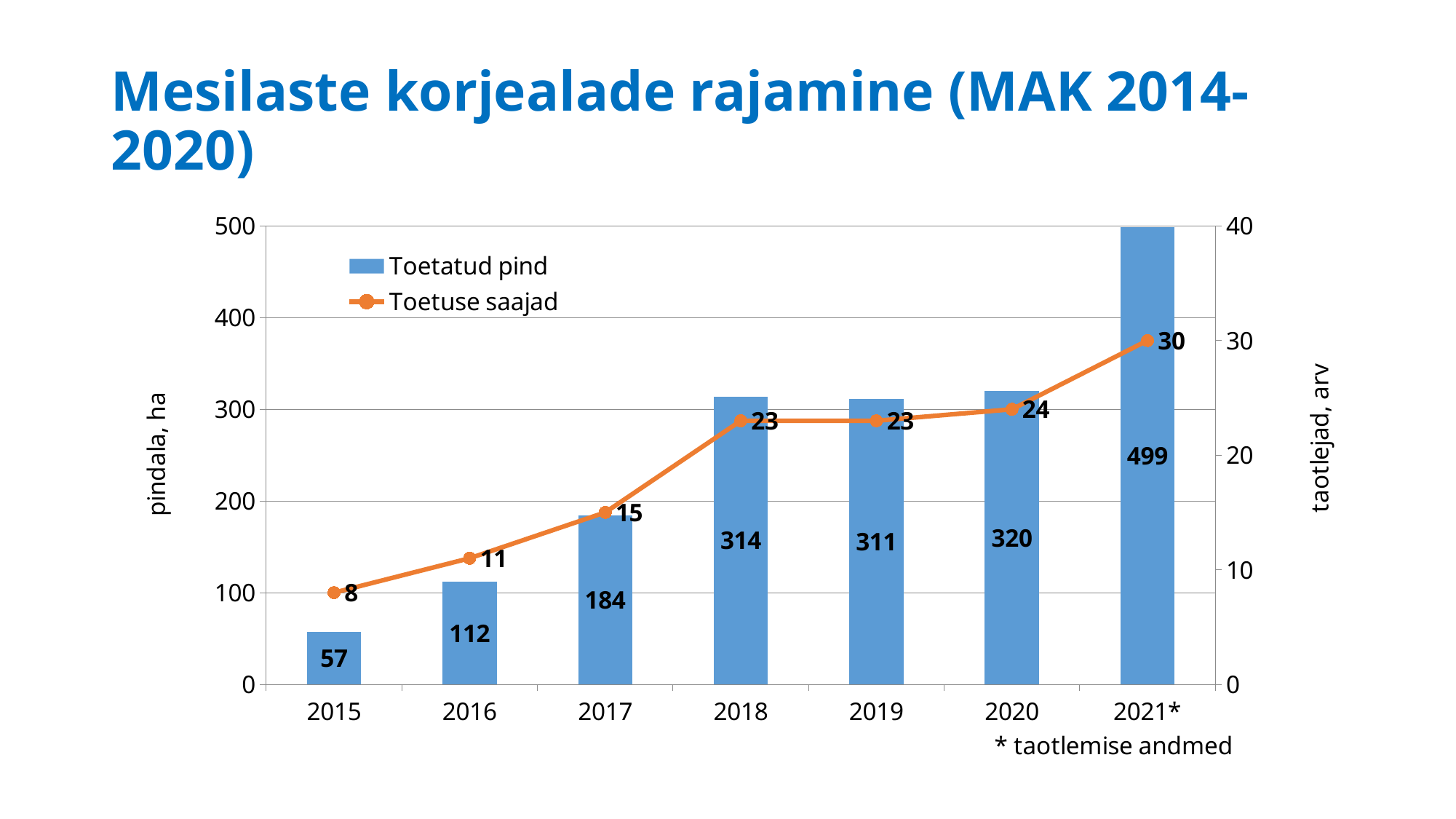
What is the difference between the Toetuse saajad values for 2021* and 2020? 6 How many years are shown on the x axis? 7 What is the value of Toetuse saajad for 2016? 11 Which year has the highest Toetatud pind value? 2021* What is the value of Toetatud pind for 2018? 314 Does the Toetuse saajad series rise or fall from 2015 to 2021*? Rise What kind of chart is shown on the slide? Combined bar and line chart What is the difference between the Toetatud pind values for 2021* and 2020? 179 How many series does the legend list? 2 Which is larger, the Toetatud pind value for 2018 or for 2019? 2018 Which year has the lowest Toetuse saajad value? 2015 What is the label of the left vertical axis? pindala, ha